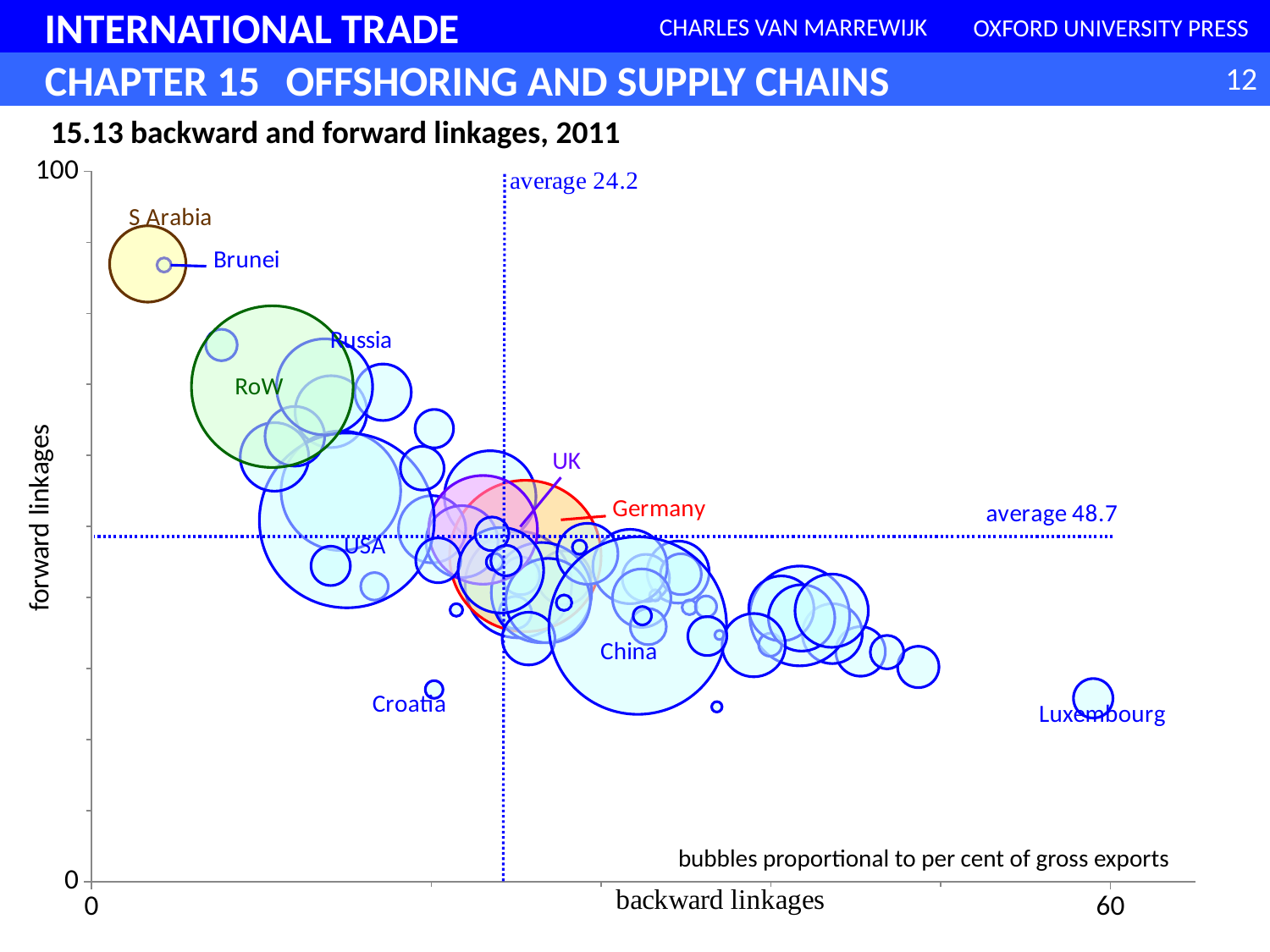
What kind of chart is shown on the slide? bubble chart Is the forward linkages value for Croatia greater or less than 40? less What is the average value of forward linkages marked by the horizontal dotted line? 48.7 Is the backward linkages value for Brunei greater or less than 10? less Which labeled country has the highest backward linkages? Luxembourg What does the size of each bubble represent? per cent of gross exports Is the backward linkages value for Luxembourg greater or less than 50? greater What is the average value of backward linkages marked by the vertical dotted line? 24.2 What is the label of the vertical axis? forward linkages Which has higher forward linkages, S Arabia or China? S Arabia As backward linkages increase along the x axis, do forward linkages generally rise or fall? fall